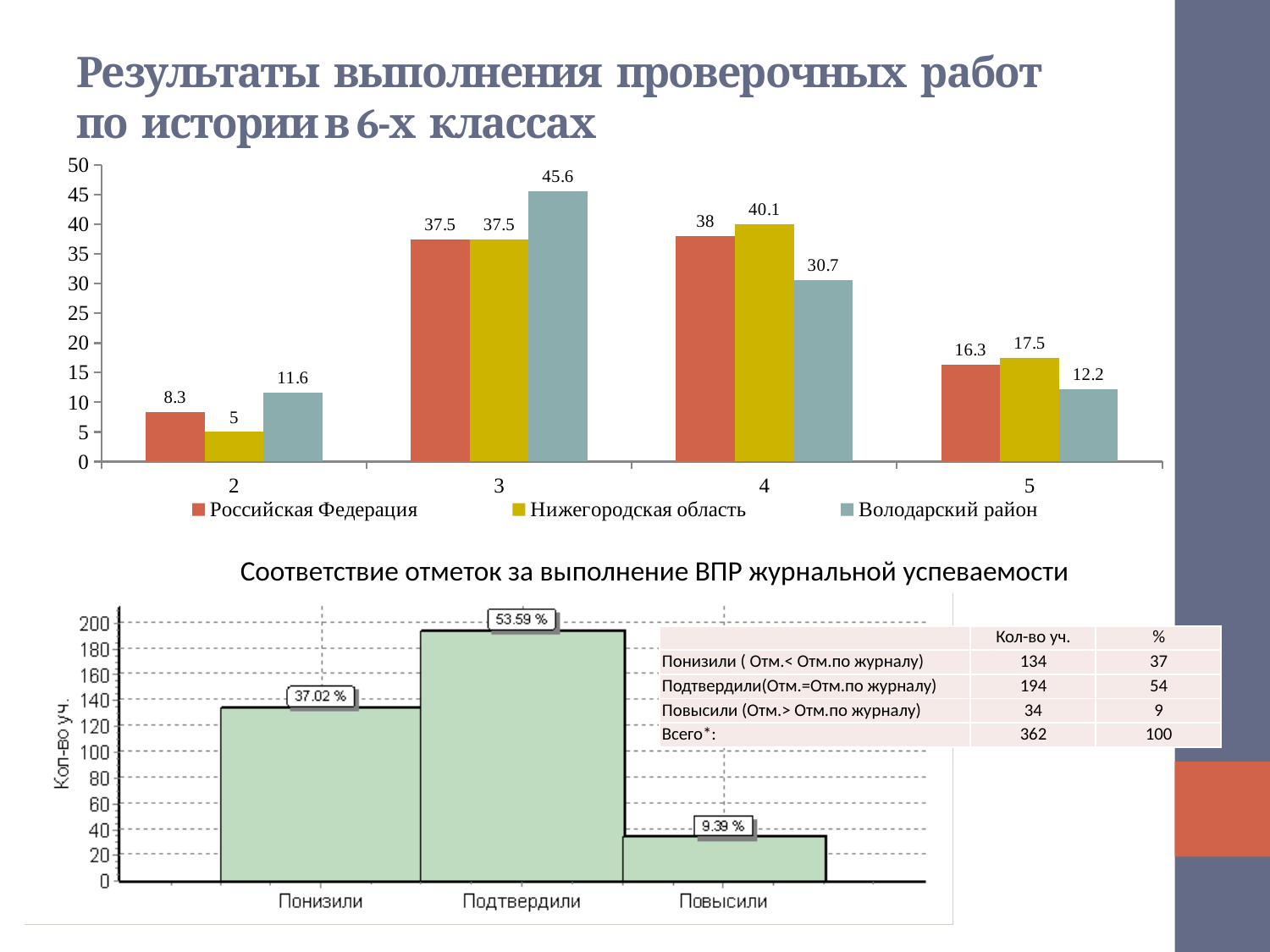
In the top chart, which category has the lowest value for Российская Федерация? 2 In the top chart, what is the difference between Нижегородская область and Володарский район for category 4? 9.4 In the top chart, what is the value for Российская Федерация for category 4? 38 In the bottom chart 'Соответствие отметок за выполнение ВПР журнальной успеваемости', which category has the lowest value? Повысили In the top chart, what is the value for Володарский район for category 3? 45.6 How many series does the legend of the top chart list? 3 In the top chart, what is the value for Нижегородская область for category 2? 5 How many categories are shown on the x axis of the top chart? 4 In the top chart, which category has the highest value for Володарский район? 3 What kind of chart is the bottom chart 'Соответствие отметок за выполнение ВПР журнальной успеваемости'? Bar chart In the bottom chart 'Соответствие отметок за выполнение ВПР журнальной успеваемости', what percentage label is shown for Подтвердили? 53.59 % In the top chart, for category 5, which is larger: Нижегородская область or Володарский район? Нижегородская область